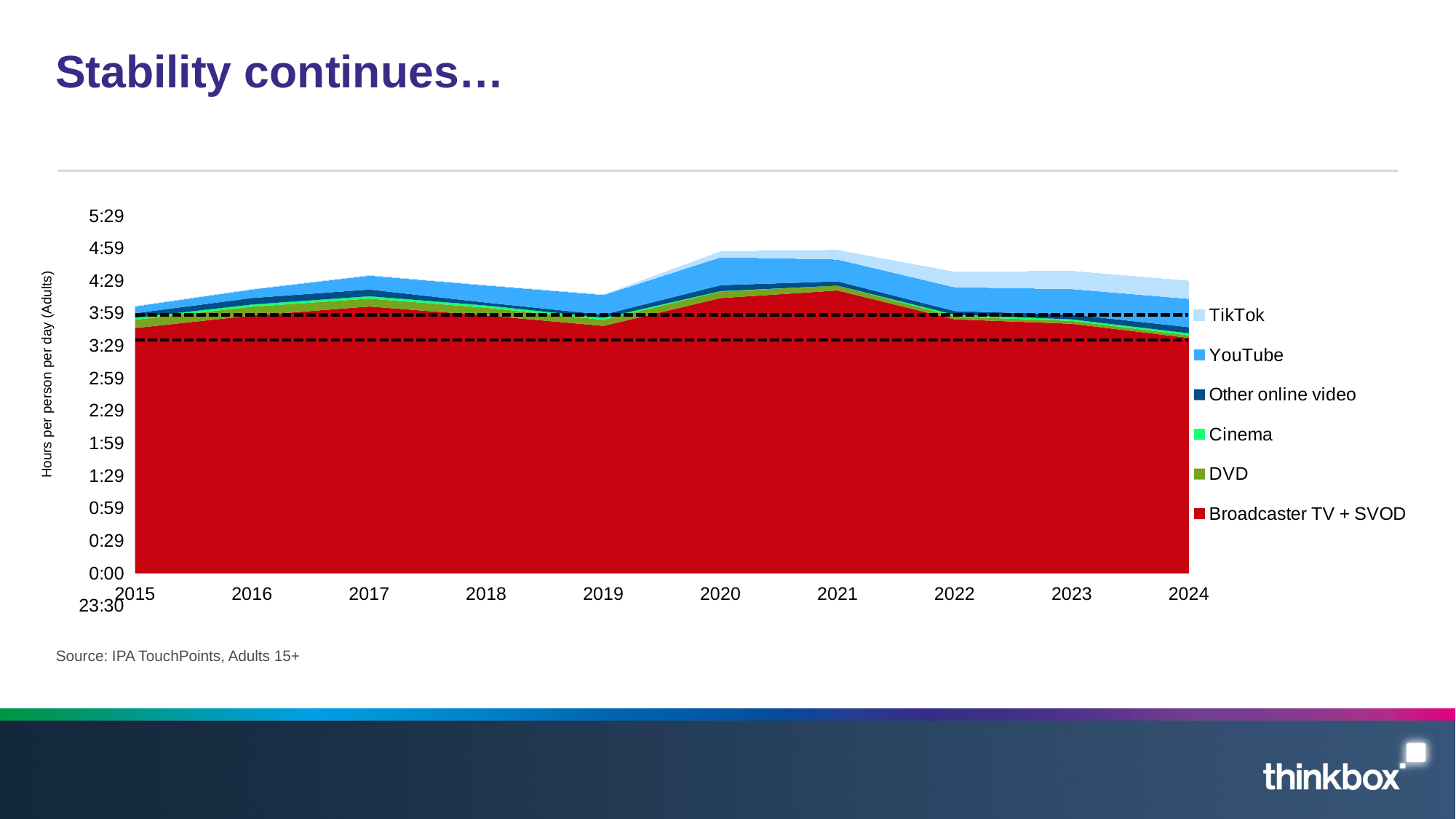
How many series does the chart's legend list? 6 Is the value for Broadcaster TV + SVOD in 2021 greater or less than 3:59? greater How many years are plotted along the x axis of the chart? 10 What is the label on the chart's y axis? Hours per person per day (Adults) Which series takes up the largest share of the stacked area in every year? Broadcaster TV + SVOD What kind of chart is shown on the slide? Stacked area chart Is the total stacked value for 2019 greater or less than 4:29? less Is the total stacked value for 2021 greater or less than 4:29? greater Is the total stacked value in 2021 larger or smaller than in 2015? larger What is the title of the slide containing the chart? Stability continues… Does the total stacked value rise or fall from 2021 to 2024? fall